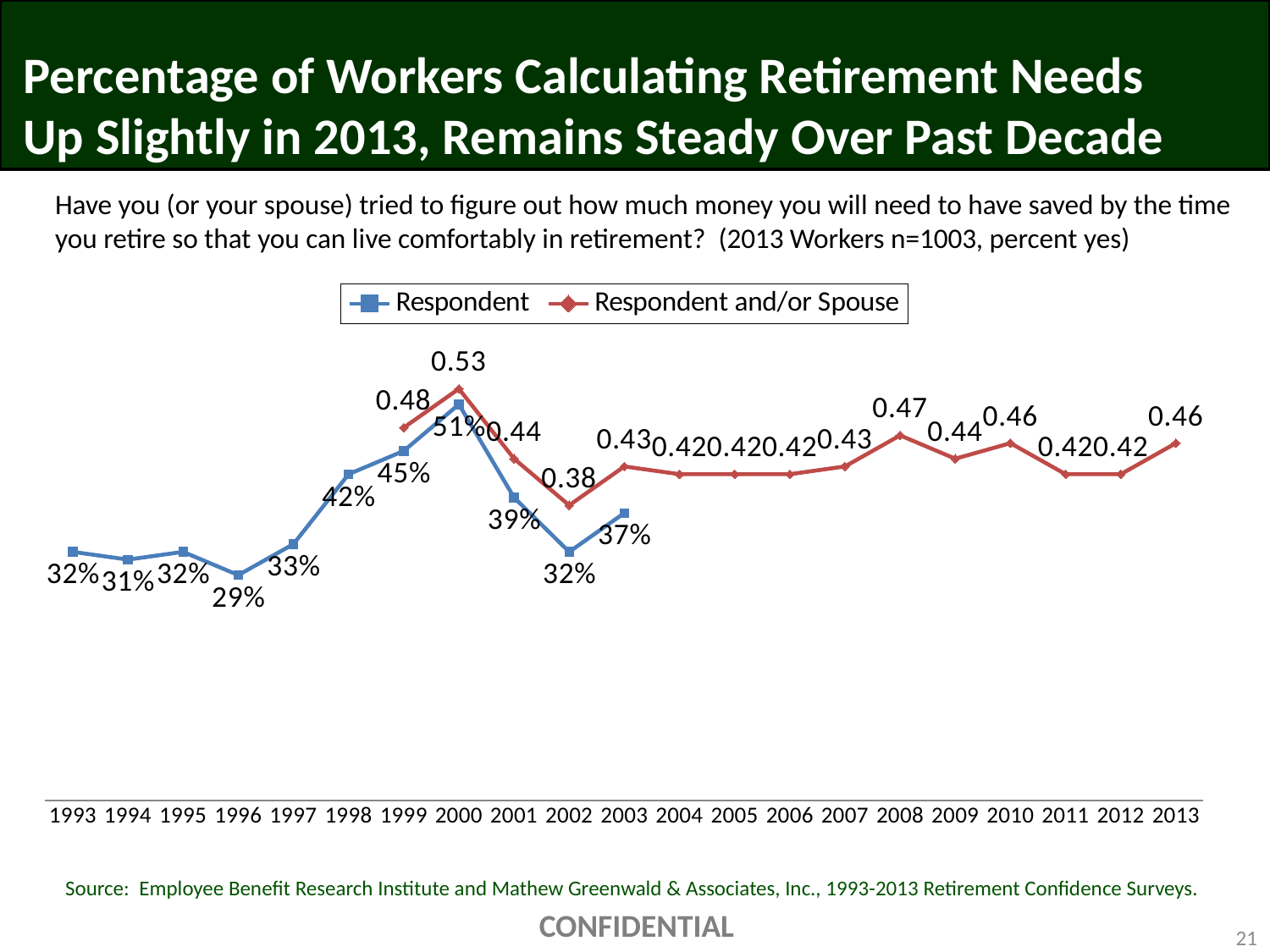
What is the difference between the Respondent values in 2000 and 1996? 22 percentage points How many series does the legend list? 2 In which year does the Respondent and/or Spouse series reach its highest value? 2000 What is the value for the Respondent series in 2000? 51% How much higher is the Respondent and/or Spouse value in 2000 than in 2002? 0.15 What is the value for the Respondent and/or Spouse series in 2013? 0.46 What is the lowest value shown for the Respondent and/or Spouse series? 0.38 What kind of chart is shown on the slide? Line chart What is the value for the Respondent series in 2003? 37% In which year is the Respondent series at its lowest value? 1996 For the Respondent and/or Spouse series, which year has the larger value, 2008 or 2009? 2008 How many years are shown on the x axis? 21